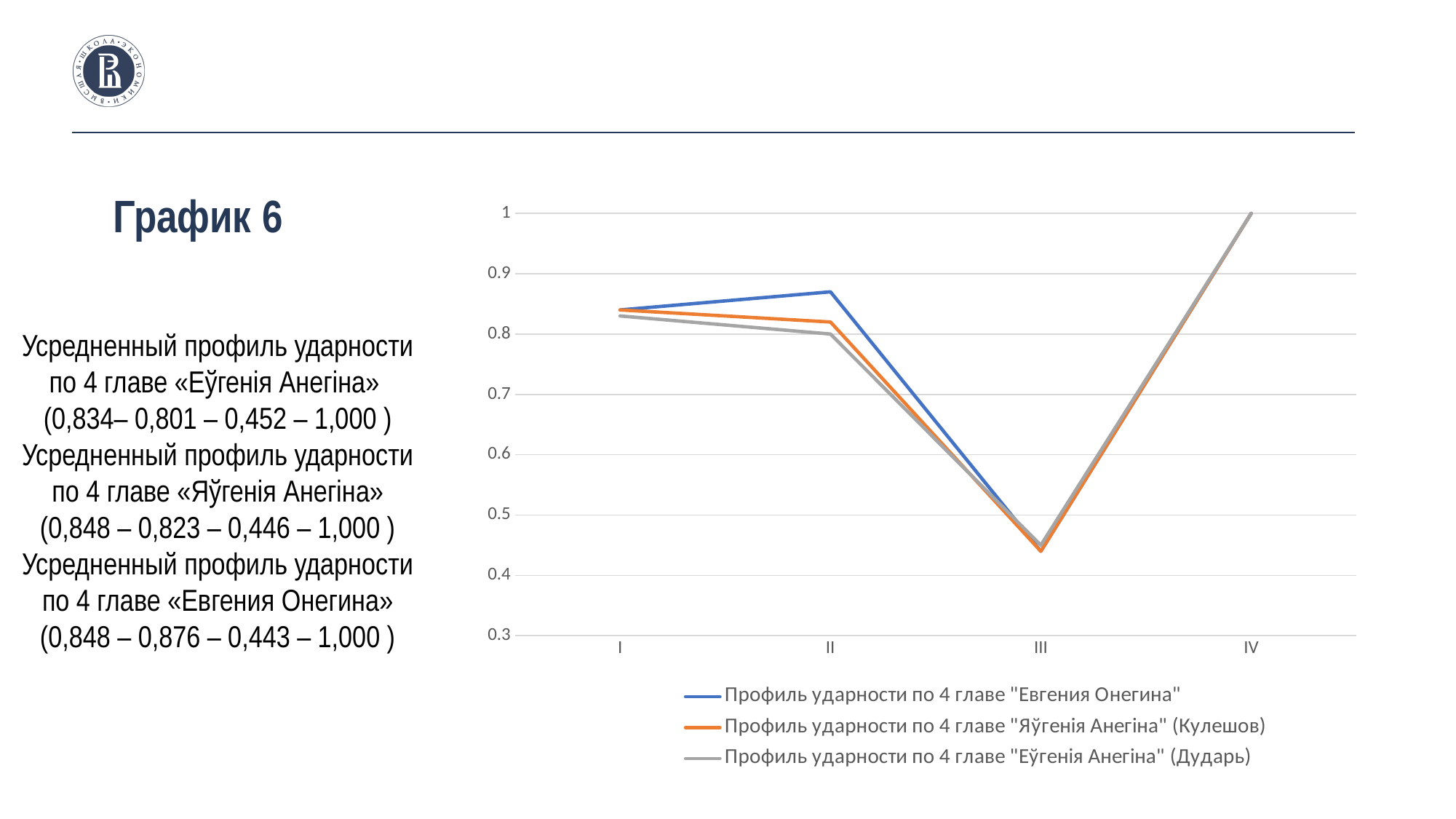
What is the value at IV for the series "Профиль ударности по 4 главе "Евгения Онегина""? 1 How many points are plotted along the x axis for each series? 4 How many series does the legend list? 3 At which x-axis category does the series "Профиль ударности по 4 главе "Яўгенія Анегіна" (Кулешов)" reach its highest value? IV At which x-axis category does the series "Профиль ударности по 4 главе "Евгения Онегина"" reach its lowest value? III Do the values of all three series rise or fall from II to III? fall Is the value at II for the series "Профиль ударности по 4 главе "Евгения Онегина"" greater or less than 0.8? greater What colour is the line for the series "Профиль ударности по 4 главе "Яўгенія Анегіна" (Кулешов)"? orange Is the value at III for the series "Профиль ударности по 4 главе "Еўгенія Анегіна" (Дударь)" greater or less than 0.5? less At II, which series has the larger value: "Евгения Онегина" or "Еўгенія Анегіна" (Дударь)? Евгения Онегина What kind of chart is shown on the slide? line chart What is the title of the chart shown on the slide? График 6